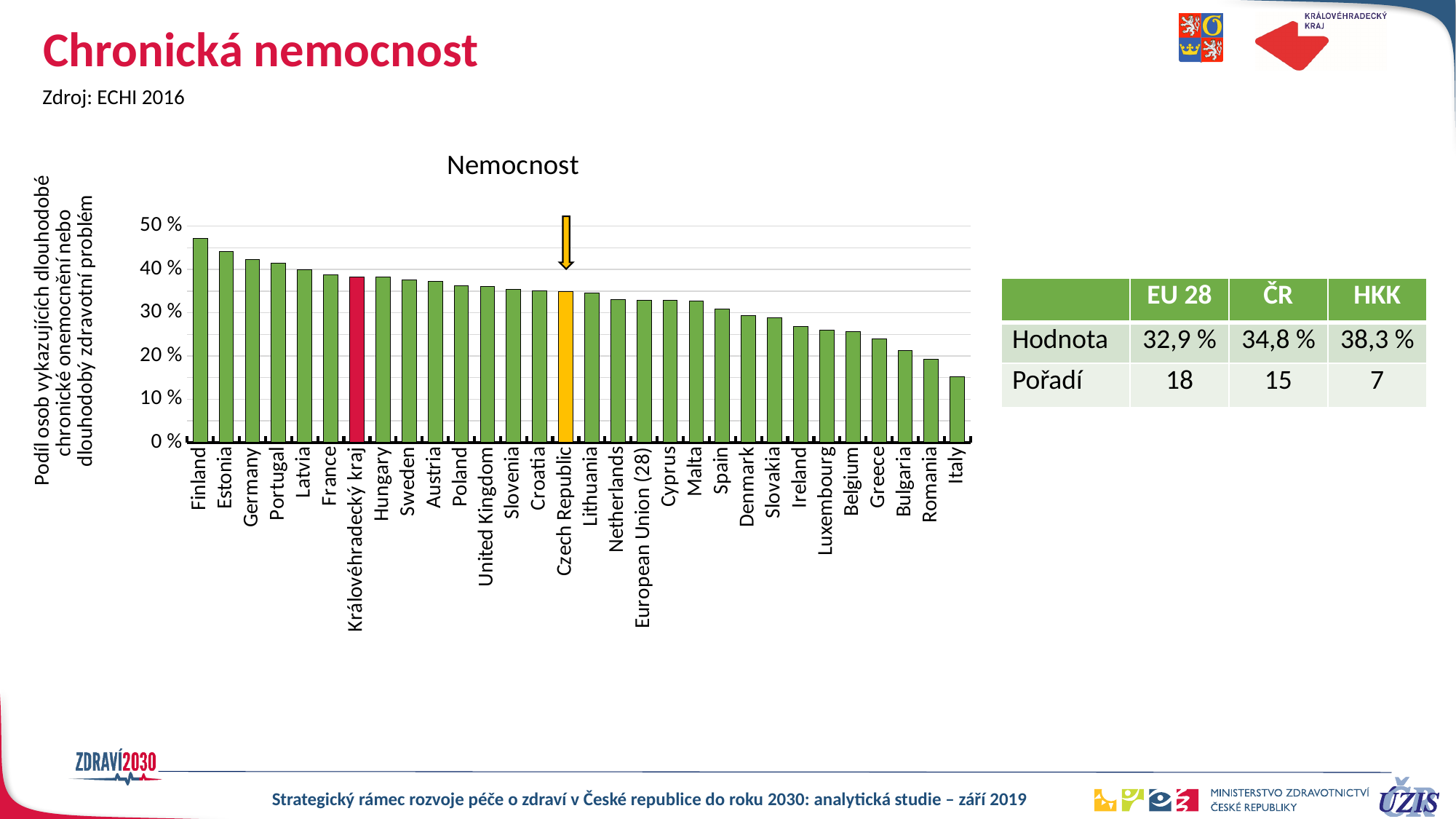
How many countries/regions are shown as bars in the chart? 30 Is the value for Finland greater or less than 40 %? greater Do the values rise or fall from left to right along the x axis? fall Is the value for Italy greater or less than 20 %? less Which country has the highest value in the chart? Finland What type of chart is shown on the slide? bar chart Which country has the lowest value in the chart? Italy Is the value for Greece greater or less than 30 %? less According to the table, what is the difference between the values for HKK and ČR? 3,5 % Which has a larger value, Germany or Spain? Germany According to the table, what is the value (Hodnota) for HKK? 38,3 % What is the title of the chart? Nemocnost